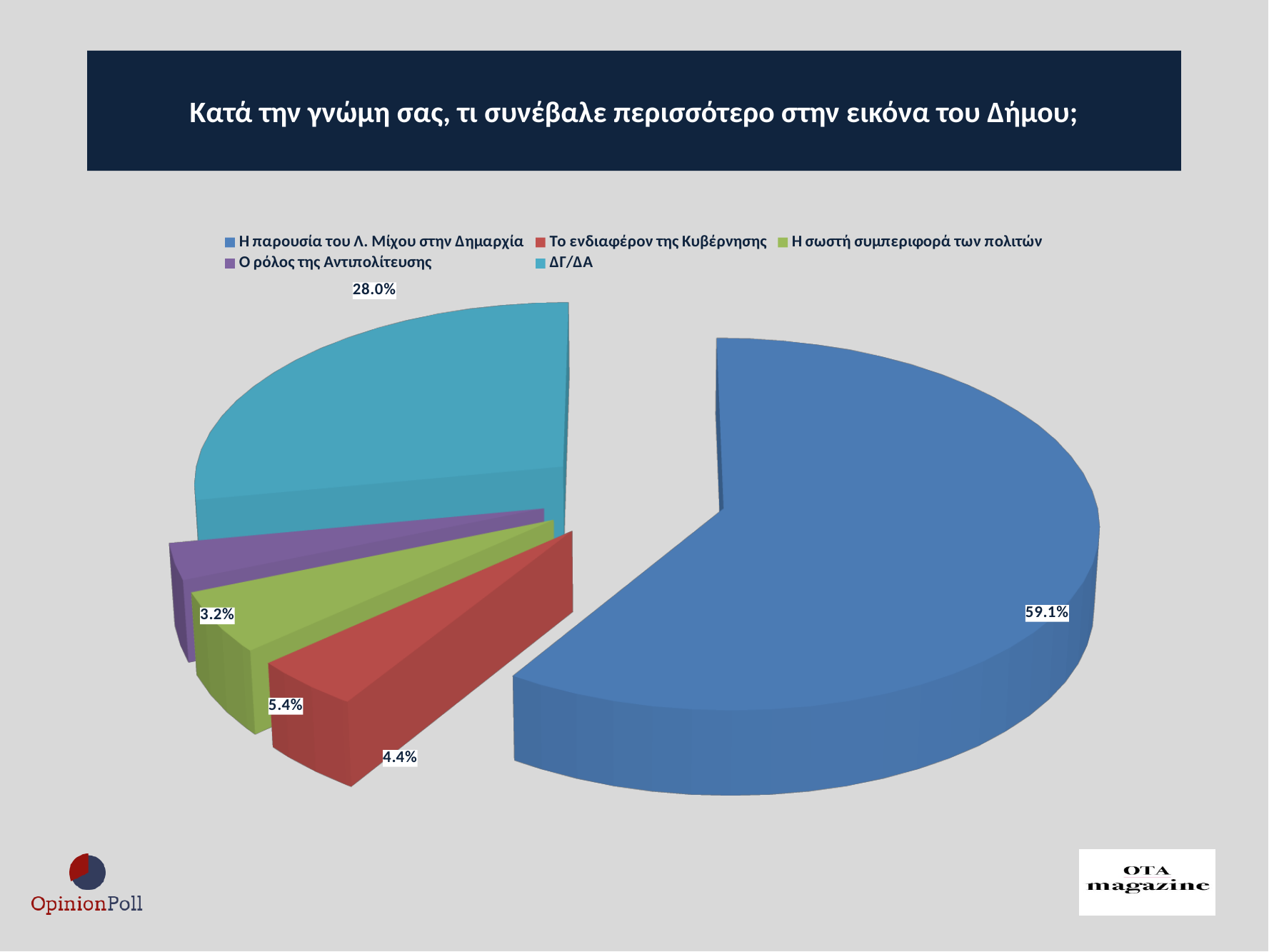
What percentage is shown for "Η παρουσία του Λ. Μίχου στην Δημαρχία"? 59.1% What percentage is shown for "ΔΓ/ΔΑ"? 28.0% What is the difference in percentage points between "Η παρουσία του Λ. Μίχου στην Δημαρχία" and "ΔΓ/ΔΑ"? 31.1 Which category has the smallest share of the pie? Ο ρόλος της Αντιπολίτευσης Which is larger, the share for "Η σωστή συμπεριφορά των πολιτών" or the share for "Το ενδιαφέρον της Κυβέρνησης"? Η σωστή συμπεριφορά των πολιτών What colour is the slice for "ΔΓ/ΔΑ"? cyan What percentage is shown for "Ο ρόλος της Αντιπολίτευσης"? 3.2% How many slices does the pie chart have? 5 What kind of chart is shown on the slide? pie chart What percentage is shown for "Το ενδιαφέρον της Κυβέρνησης"? 4.4% Which category has the largest share of the pie? Η παρουσία του Λ. Μίχου στην Δημαρχία What percentage is shown for "Η σωστή συμπεριφορά των πολιτών"? 5.4%